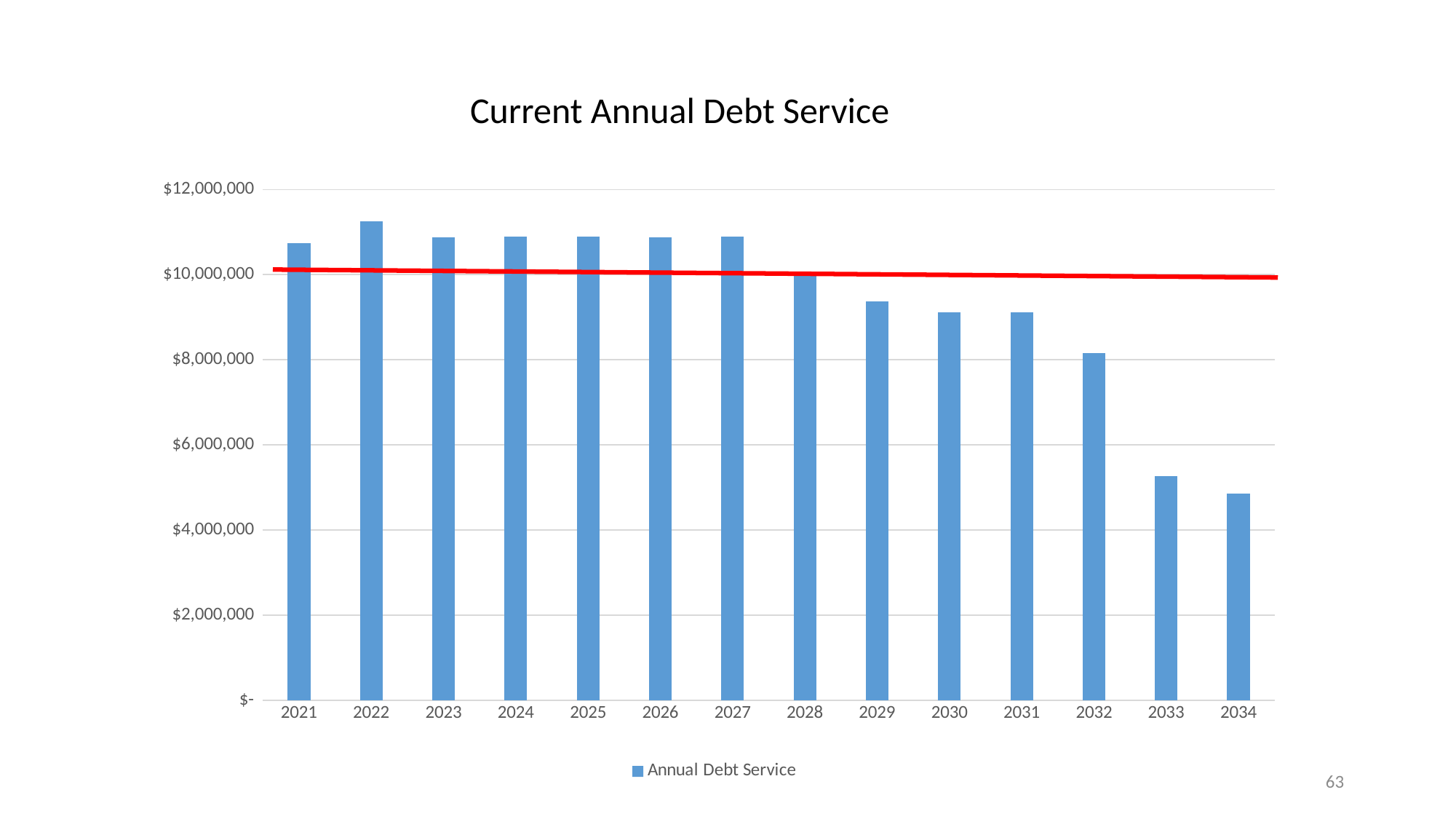
Is the annual debt service for 2034 greater or less than $4,000,000? greater Is the annual debt service for 2021 greater or less than $10,000,000? greater Which year has the highest annual debt service? 2022 Do the annual debt service values generally rise or fall from 2021 to 2034? fall Is the annual debt service for 2033 greater or less than $6,000,000? less How many years are shown on the x axis of the chart? 14 What is the title of the chart? Current Annual Debt Service What type of chart is shown on the slide? bar chart Which year has the lowest annual debt service? 2034 What is the name of the series listed in the legend? Annual Debt Service Which year has a larger annual debt service, 2029 or 2032? 2029 How many series does the legend list? 1